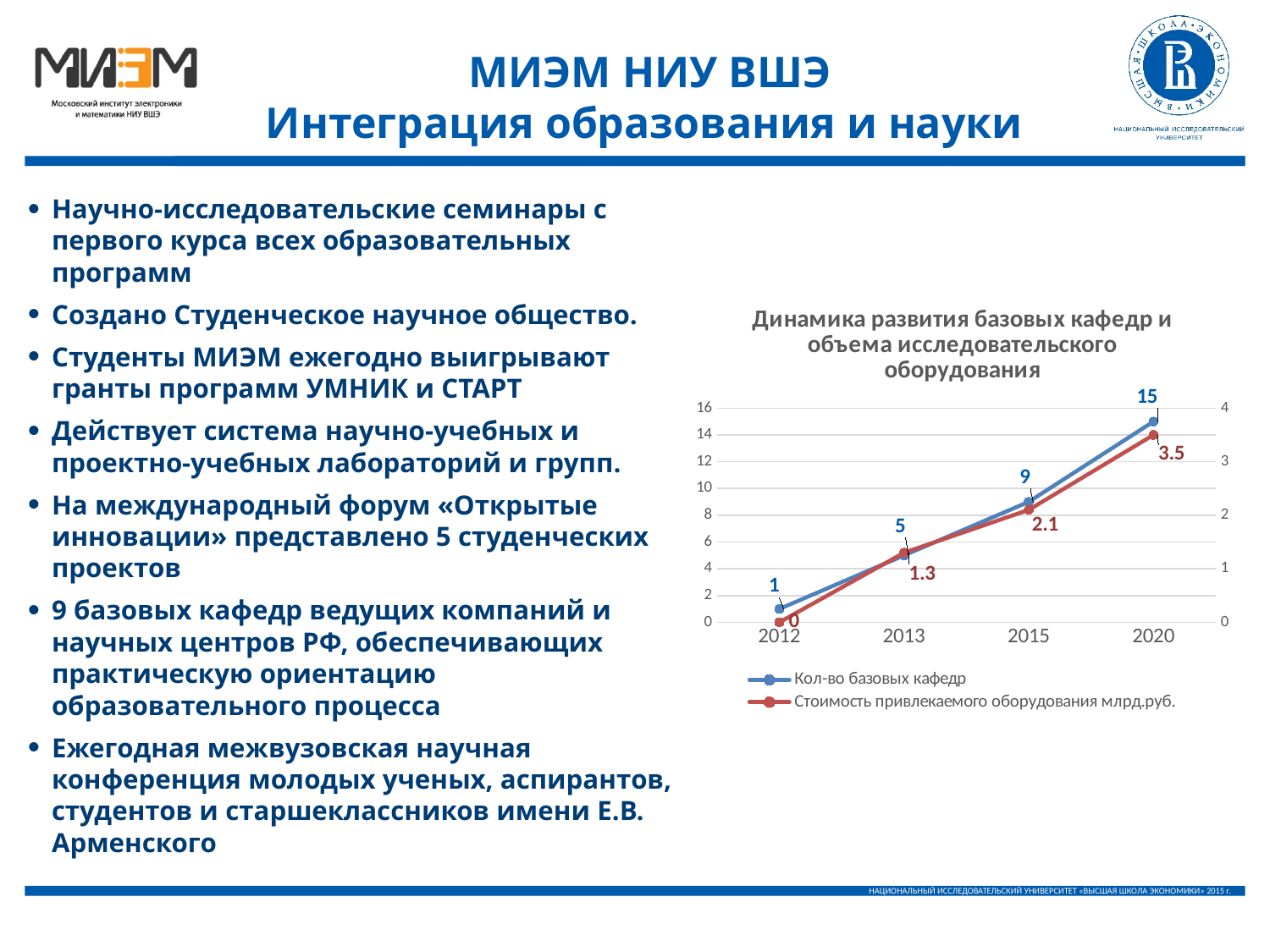
In which year is 'Стоимость привлекаемого оборудования млрд.руб.' highest? 2020 Does 'Кол-во базовых кафедр' rise or fall from 2012 to 2020? rise What type of chart is shown on the slide? line chart What is the title of the chart? Динамика развития базовых кафедр и объема исследовательского оборудования By how much did 'Кол-во базовых кафедр' increase from 2015 to 2020? 6 What is the value of 'Кол-во базовых кафедр' in 2012? 1 What is the value of 'Стоимость привлекаемого оборудования млрд.руб.' in 2020? 3.5 How many years are plotted on the x axis of the chart? 4 How many series does the chart legend list? 2 What is the value of 'Стоимость привлекаемого оборудования млрд.руб.' in 2013? 1.3 In which year is 'Кол-во базовых кафедр' lowest? 2012 What is the value of 'Кол-во базовых кафедр' in 2020? 15